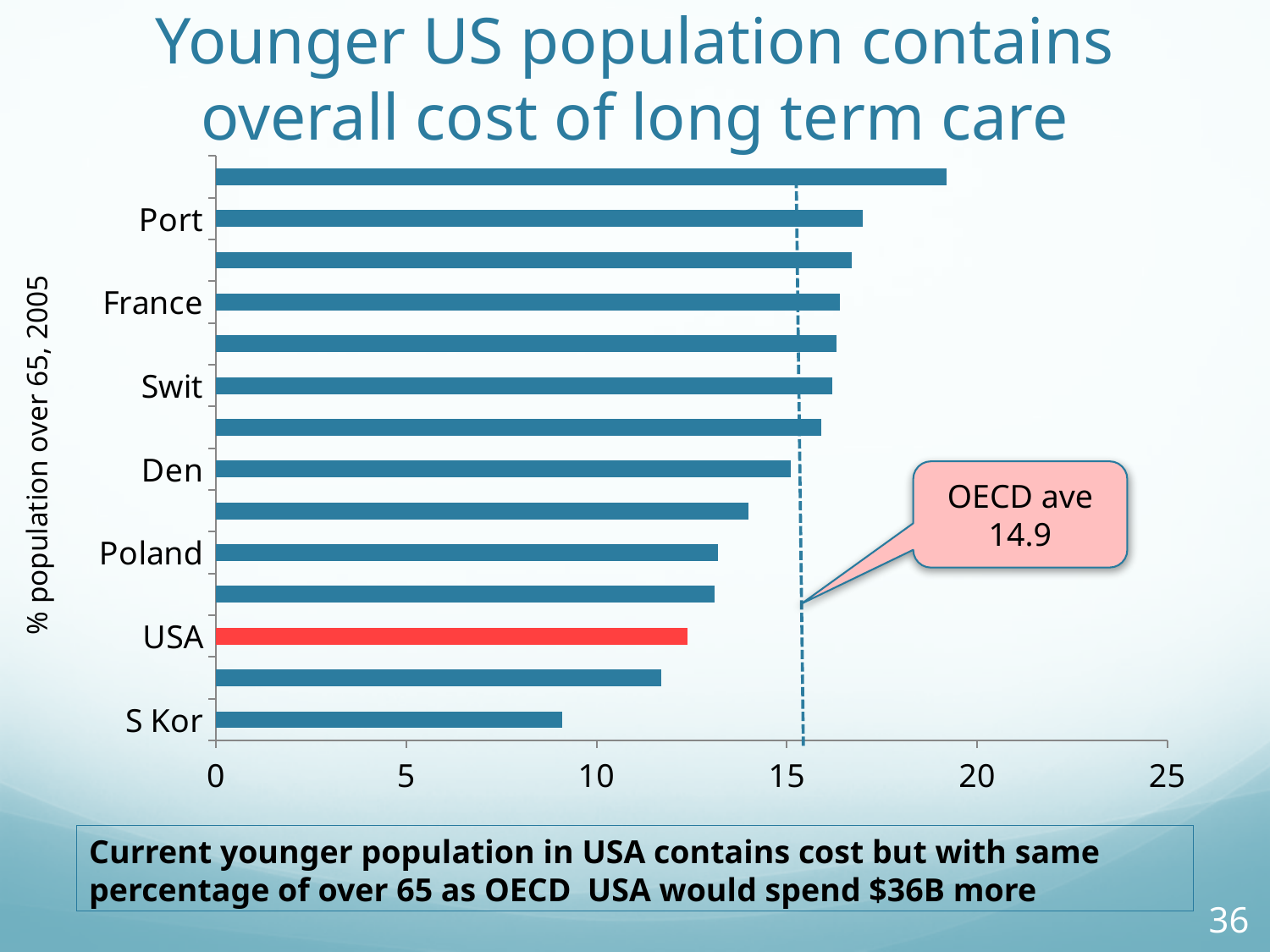
What kind of chart is shown on the slide? bar chart What OECD average value is shown in the callout on the chart? 14.9 Is the value for S Kor greater or less than 10? less Is the value for USA greater or less than 15? less Is the value for Port greater or less than 15? greater Which is larger, the value for France or the value for Poland? France Which is larger, the value for Port or the value for USA? Port Which is larger, the value for USA or the value for S Kor? USA Do the bars get longer or shorter going from the top of the chart to the bottom? shorter How many bars are plotted in the chart? 14